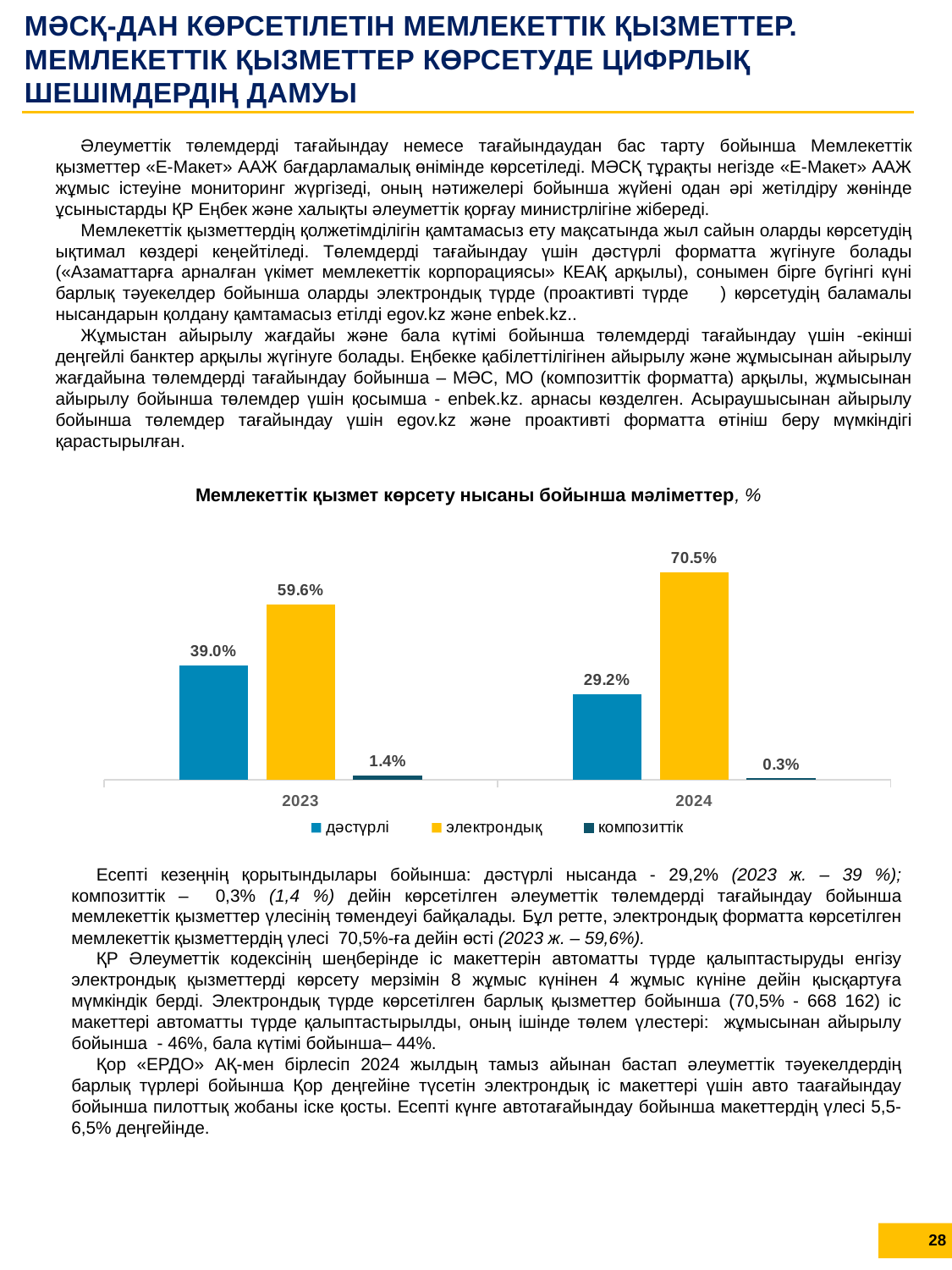
Which series has the lowest value in 2023? композиттік What is the value for электрондық in 2024? 70.5% What is the difference between the дәстүрлі values for 2023 and 2024? 9.8% Which is larger: дәстүрлі in 2023 or дәстүрлі in 2024? дәстүрлі in 2023 How many series does the legend list? 3 What is the value for электрондық in 2023? 59.6% What kind of chart is shown on the slide? bar chart Which series has the highest value in 2024? электрондық What is the difference between the электрондық values for 2024 and 2023? 10.9% What is the value for дәстүрлі in 2023? 39.0% How many categories are shown on the x axis? 2 What is the value for композиттік in 2024? 0.3%